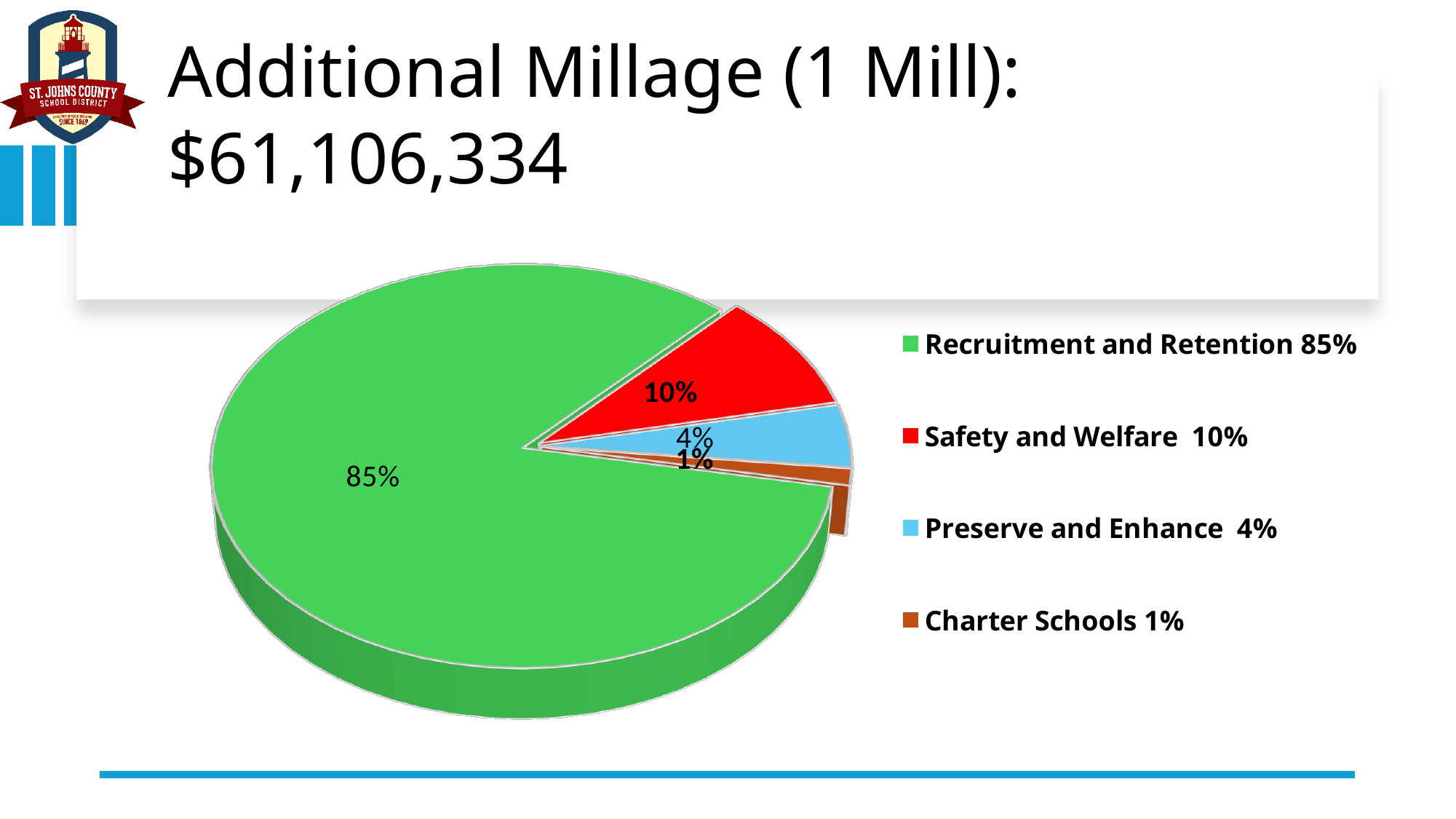
What colour is the slice for Safety and Welfare? Red Which category has the largest slice of the pie? Recruitment and Retention Which category has the smallest slice of the pie? Charter Schools How many categories does the pie chart show? 4 What share of the pie does Charter Schools represent? 1% What kind of chart is shown on the slide? Pie chart What share of the pie does Preserve and Enhance represent? 4% What share of the pie does Recruitment and Retention represent? 85% What is the difference in percentage points between Recruitment and Retention and Safety and Welfare? 75% Which is larger, the share for Preserve and Enhance or the share for Charter Schools? Preserve and Enhance What total dollar amount is given in the slide title for the additional millage? $61,106,334